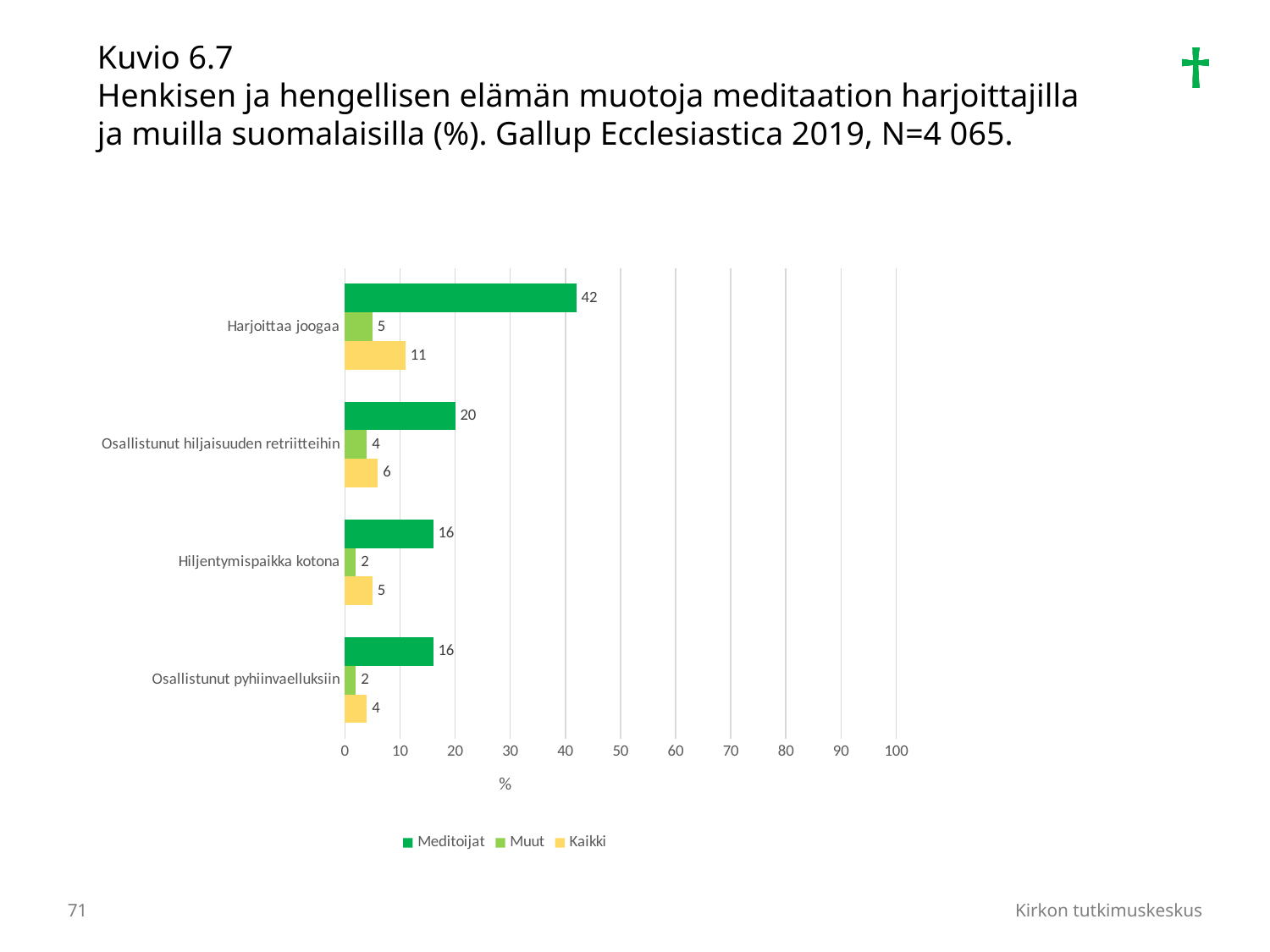
Which is larger: the Kaikki value for Harjoittaa joogaa or the Kaikki value for Hiljentymispaikka kotona? Harjoittaa joogaa Which category has the highest value for Meditoijat? Harjoittaa joogaa How many series does the legend list? 3 What is the label of the horizontal axis? % What is the value for Meditoijat in the Harjoittaa joogaa category? 42 What is the value for Kaikki in the Osallistunut hiljaisuuden retriitteihin category? 6 How many categories are shown on the chart? 4 Which category has the lowest value for Kaikki? Osallistunut pyhiinvaelluksiin What kind of chart is shown on the slide? bar chart What is the difference between the Meditoijat and Muut values for Harjoittaa joogaa? 37 What is the value for Muut in the Hiljentymispaikka kotona category? 2 Is the Meditoijat value for Osallistunut hiljaisuuden retriitteihin greater or less than 30? less